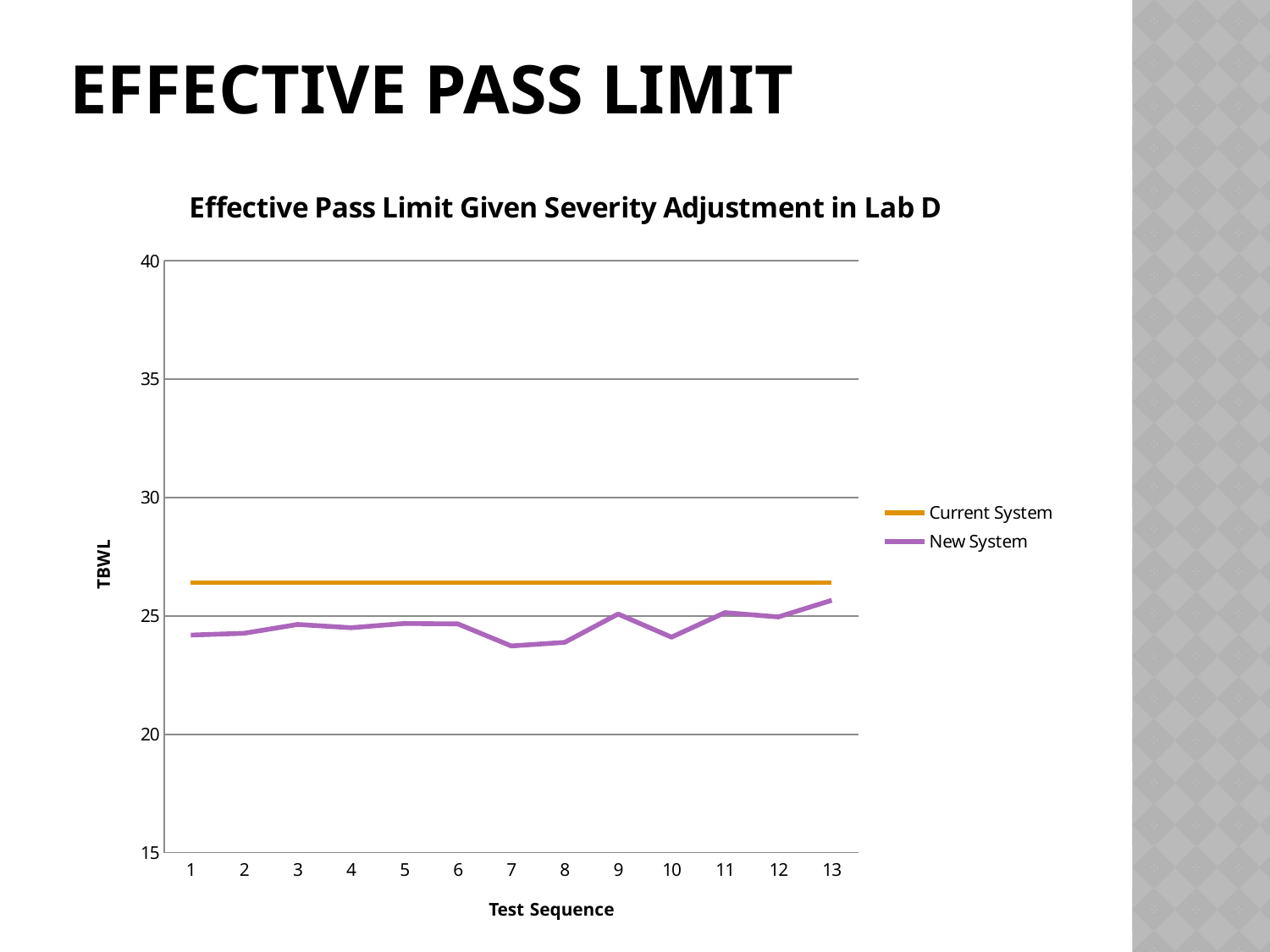
Is the value for the Current System greater or less than 25? greater Does the New System line rise or fall from test sequence 10 to test sequence 13? rise Is the value for the New System at test sequence 13 greater or less than 25? greater Is the value for the Current System greater or less than 30? less What is the label on the y axis of the chart? TBWL What kind of chart is shown on the slide? line chart At test sequence 7, which series has the larger value, Current System or New System? Current System How many test sequence points are plotted along the x axis? 13 At which test sequence does the New System reach its lowest value? 7 At which test sequence does the New System reach its highest value? 13 How many series does the legend list? 2